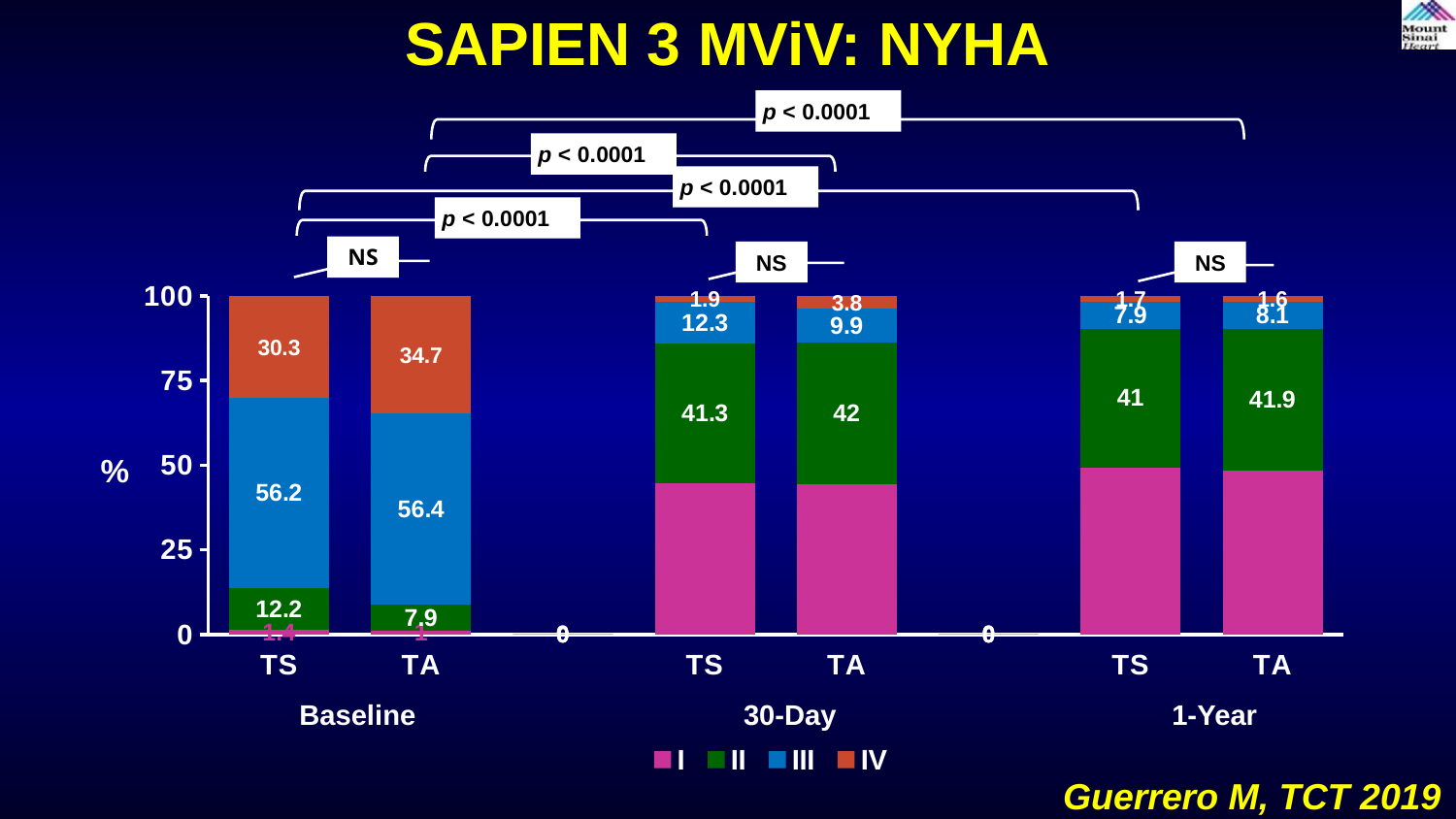
Is the NYHA class I value for the 30-Day TS bar greater or less than 25? greater How many series does the legend list? 4 What is the value for NYHA class IV in the 1-Year TA bar? 1.6 How many stacked bars are plotted in the chart? 6 What is the value for NYHA class IV in the Baseline TS bar? 30.3 At 30-Day, which group has the larger NYHA class III value, TS or TA? TS What is the value for NYHA class II in the 30-Day TA bar? 42 What is the value for NYHA class III in the Baseline TA bar? 56.4 What is the difference between the NYHA class IV values for Baseline TA and Baseline TS? 4.4 What is the value for NYHA class III in the 1-Year TS bar? 7.9 What kind of chart is shown on the slide? Stacked bar chart What are the legend entries of the chart? I, II, III, IV